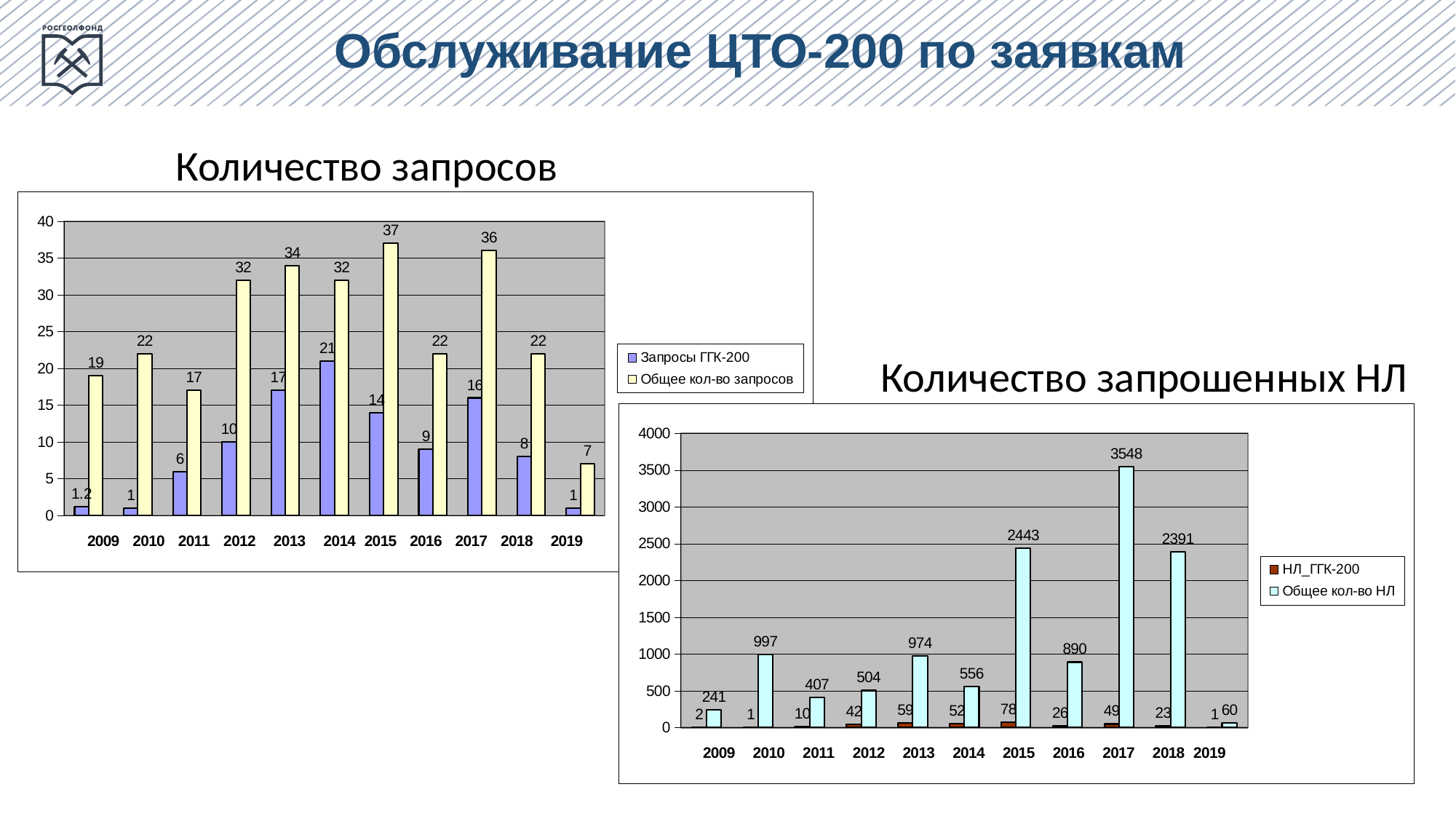
In the chart 'Количество запросов', which year has the highest value of 'Общее кол-во запросов'? 2015 In the chart 'Количество запрошенных НЛ', what is the difference between 'Общее кол-во НЛ' in 2017 and in 2015? 1105 In the chart 'Количество запросов', what is the value of 'Общее кол-во запросов' for 2015? 37 In the chart 'Количество запросов', what is the difference between 'Общее кол-во запросов' and 'Запросы ГГК-200' in 2017? 20 In the chart 'Количество запросов', how many series does the legend list? 2 What type of chart is 'Количество запрошенных НЛ'? Bar chart In the chart 'Количество запрошенных НЛ', how many years are shown on the x axis? 11 In the chart 'Количество запрошенных НЛ', what is the value of 'НЛ_ГГК-200' for 2015? 78 In the chart 'Количество запрошенных НЛ', what is the value of 'Общее кол-во НЛ' for 2017? 3548 In the chart 'Количество запрошенных НЛ', which year has the lowest value of 'Общее кол-во НЛ'? 2019 In the chart 'Количество запрошенных НЛ', which is larger: 'Общее кол-во НЛ' in 2015 or in 2018? 2015 In the chart 'Количество запросов', what is the value of 'Запросы ГГК-200' for 2014? 21